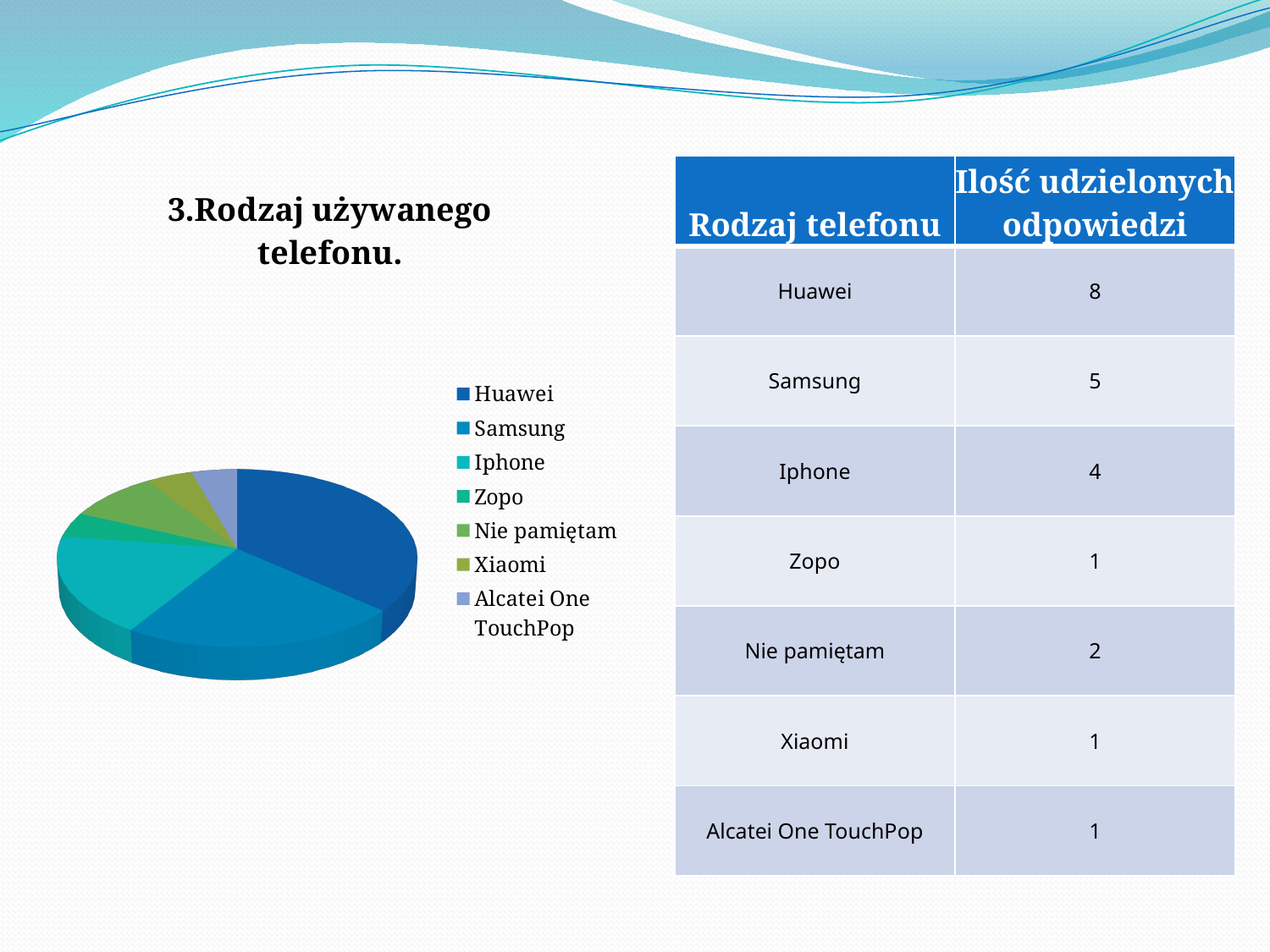
Which received more responses, Samsung or Iphone? Samsung How many responses did Nie pamiętam receive? 2 What is the difference between the number of responses for Huawei and Samsung? 3 Which phone type received the most responses? Huawei How many responses did Iphone receive? 4 What kind of chart is shown on the slide? pie chart How many entries does the chart legend list? 7 How many categories does the pie chart have? 7 How many responses did Huawei receive? 8 What is the title of the chart? 3.Rodzaj używanego telefonu. How many responses did Samsung receive? 5 What is the total number of responses across all phone types? 22